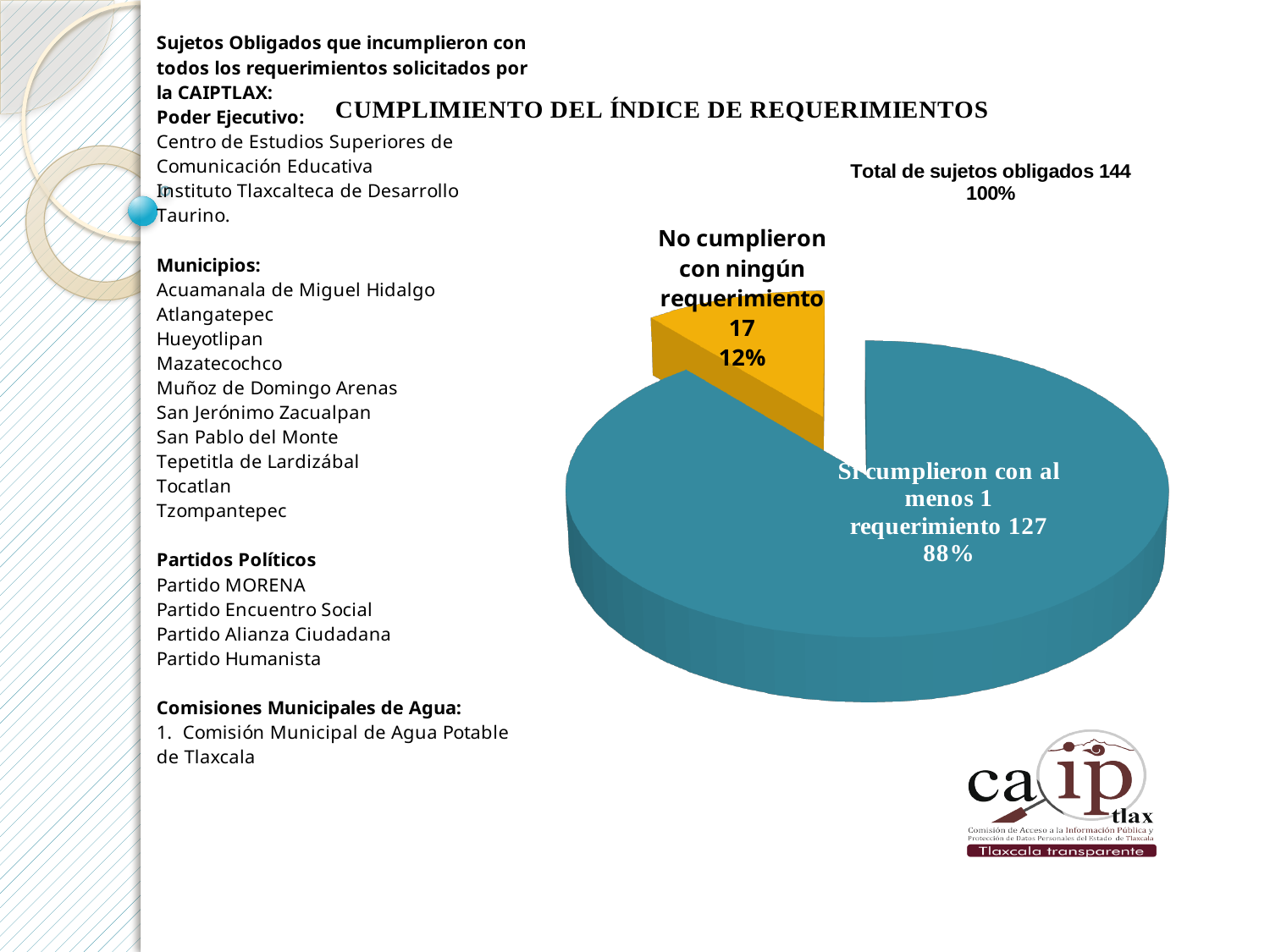
What is the value for the slice 'Sí cumplieron con al menos 1 requerimiento'? 127 What is the difference between the number of subjects that complied with at least 1 requirement and those that complied with none? 110 What percentage share does the 'Sí cumplieron con al menos 1 requerimiento' slice represent? 88% What percentage share does the 'No cumplieron con ningún requerimiento' slice represent? 12% What is the value for the slice 'No cumplieron con ningún requerimiento'? 17 What kind of chart is shown on the slide? Pie chart Which is larger: the number that complied with at least 1 requirement or the number that complied with none? Sí cumplieron con al menos 1 requerimiento What is the total number of obligated subjects shown above the pie chart? 144 Which slice of the pie chart is the smallest? No cumplieron con ningún requerimiento Which slice of the pie chart is the largest? Sí cumplieron con al menos 1 requerimiento What is the title of the chart? CUMPLIMIENTO DEL ÍNDICE DE REQUERIMIENTOS How many slices does the pie chart have? 2